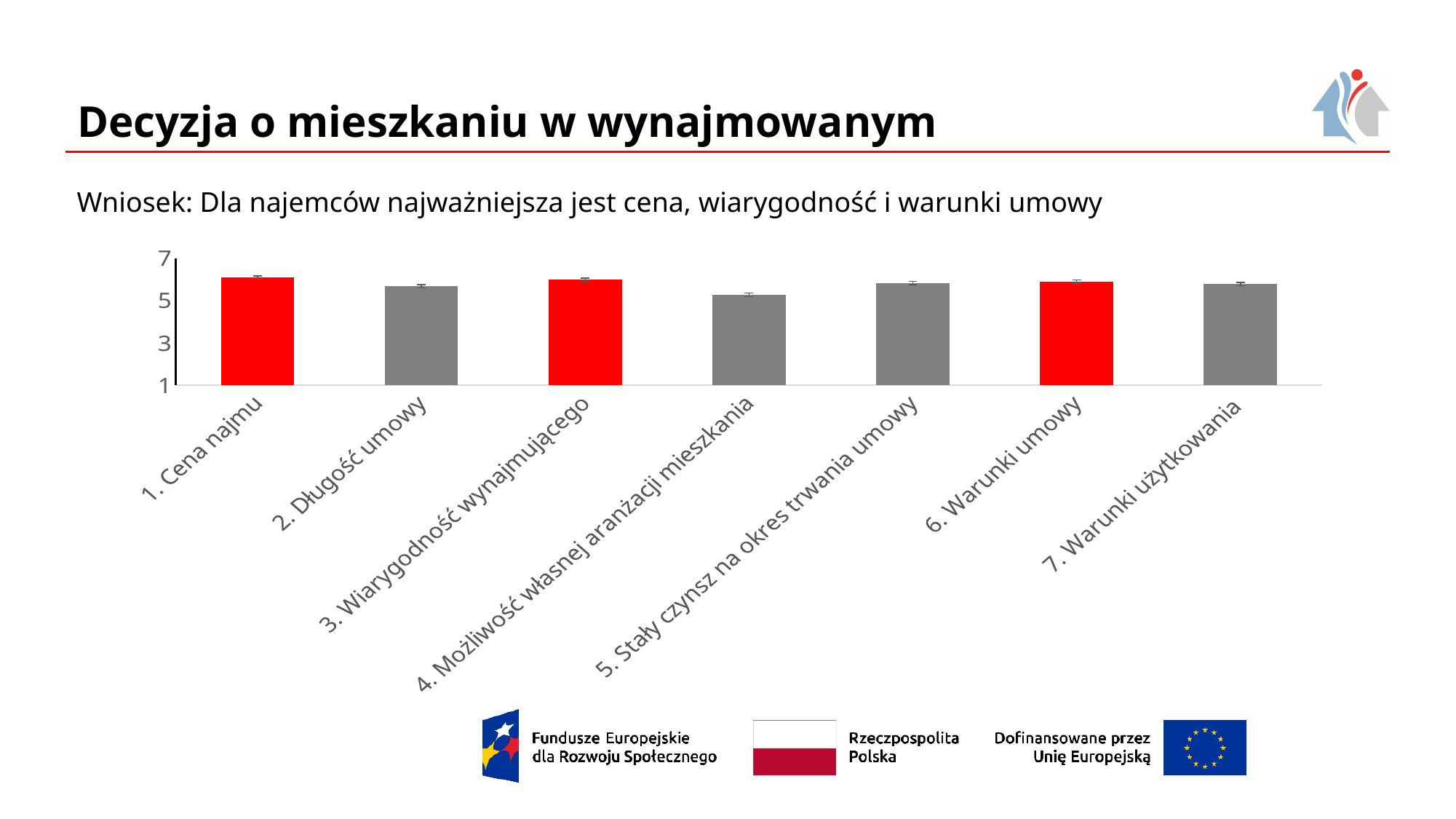
Is the value for 1. Cena najmu greater or less than 5? greater Is the value for 1. Cena najmu greater or less than 7? less Which category has the lowest bar on the chart? 4. Możliwość własnej aranżacji mieszkania Is the value for 7. Warunki użytkowania greater or less than 7? less Which is larger, the value for 3. Wiarygodność wynajmującego or the value for 4. Możliwość własnej aranżacji mieszkania? 3. Wiarygodność wynajmującego Which is larger, the value for 1. Cena najmu or the value for 4. Możliwość własnej aranżacji mieszkania? 1. Cena najmu What is the highest tick value shown on the vertical axis of the chart? 7 How many categories are plotted on the chart? 7 What kind of chart is shown on the slide? bar chart Which is larger, the value for 2. Długość umowy or the value for 4. Możliwość własnej aranżacji mieszkania? 2. Długość umowy How many bars on the chart are coloured red? 3